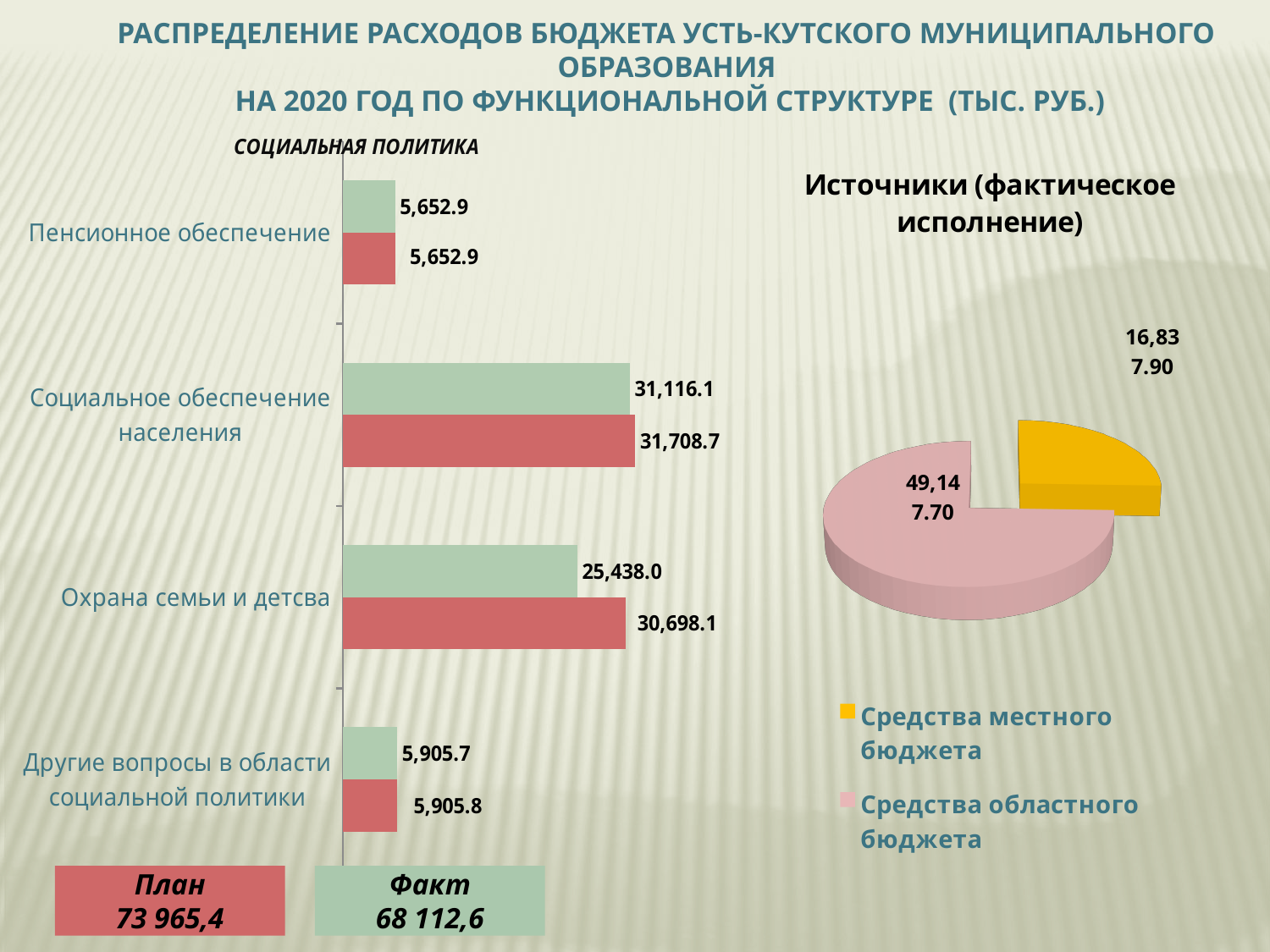
In the 'Социальная политика' bar chart, what is the difference between the План and Факт values for 'Социальное обеспечение населения'? 592.6 In the 'Социальная политика' bar chart, how many categories are shown? 4 What kind of chart is the 'Источники (фактическое исполнение)' chart on the right of the slide? pie chart In the 'Социальная политика' bar chart, what is the Факт value for 'Другие вопросы в области социальной политики'? 5,905.7 In the 'Социальная политика' bar chart, which category has the highest План value? Социальное обеспечение населения In the 'Социальная политика' bar chart, which category has the lowest Факт value? Пенсионное обеспечение In the 'Источники (фактическое исполнение)' pie chart, which slice is larger: 'Средства местного бюджета' or 'Средства областного бюджета'? Средства областного бюджета In the 'Социальная политика' bar chart, what is the Факт value for 'Социальное обеспечение населения'? 31,116.1 What kind of chart is the 'Социальная политика' chart on the left of the slide? bar chart In the 'Социальная политика' bar chart, what is the План value for 'Охрана семьи и детсва'? 30,698.1 In the 'Социальная политика' bar chart, what is the difference between the План and Факт values for 'Охрана семьи и детсва'? 5,260.1 How many entries does the legend of the 'Источники (фактическое исполнение)' pie chart list? 2